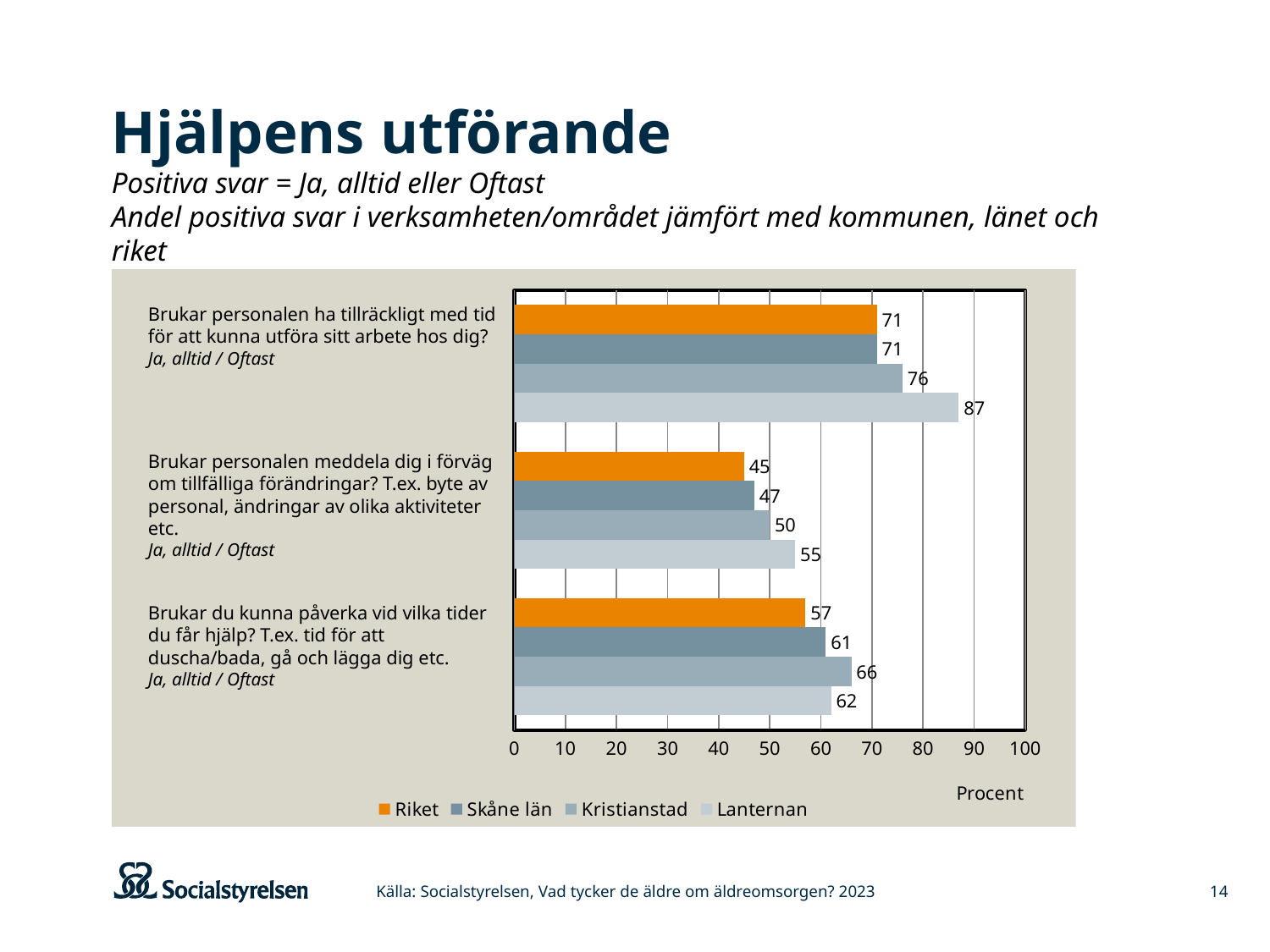
How many question categories are plotted on the chart? 3 What is the difference between Lanternan and Riket for the question "Brukar personalen ha tillräckligt med tid för att kunna utföra sitt arbete hos dig?"? 16 What is the value for Riket for the question "Brukar personalen meddela dig i förväg om tillfälliga förändringar?"? 45 Which series has the lowest value for the question "Brukar du kunna påverka vid vilka tider du får hjälp?"? Riket What is the value for Lanternan for the question "Brukar personalen ha tillräckligt med tid för att kunna utföra sitt arbete hos dig?"? 87 How many series does the legend list? 4 What is the value for Kristianstad for the question "Brukar du kunna påverka vid vilka tider du får hjälp?"? 66 What unit is shown on the x axis of the chart? Procent Is the value for Skåne län for the question "Brukar personalen meddela dig i förväg om tillfälliga förändringar?" greater or less than 50? less Which series has the highest value for the question "Brukar personalen ha tillräckligt med tid för att kunna utföra sitt arbete hos dig?"? Lanternan For the question "Brukar du kunna påverka vid vilka tider du får hjälp?", which is larger: Kristianstad or Lanternan? Kristianstad What kind of chart is shown on the slide? bar chart